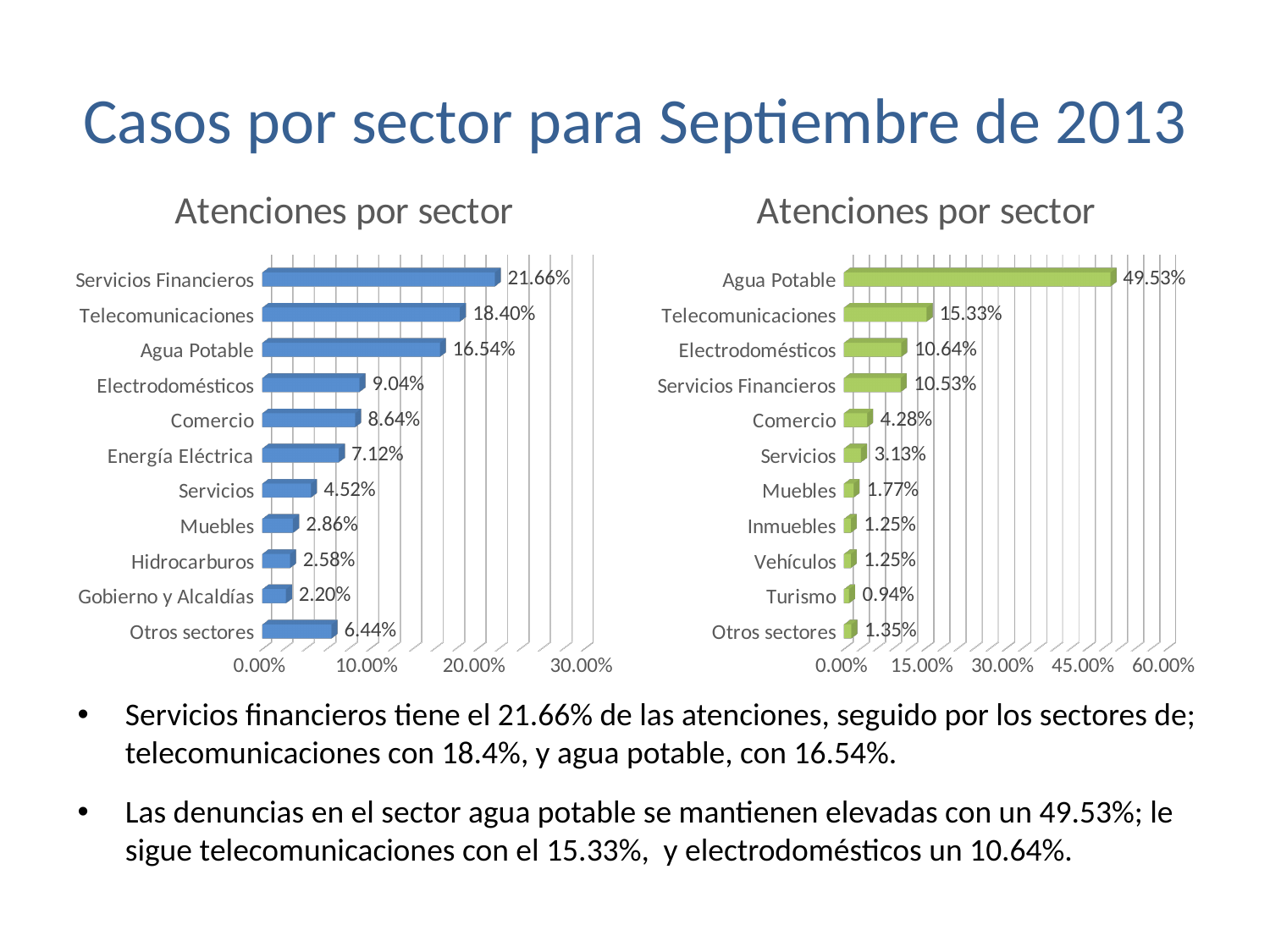
In the right chart, what is the value for Turismo? 0.94% How many sectors are shown in the right chart? 11 In the left chart, which is larger, Comercio or Servicios? Comercio What type of chart is the left chart? Bar chart In the right chart, what is the value for Agua Potable? 49.53% In the left chart, what is the difference between Servicios Financieros and Telecomunicaciones? 3.26% In the left chart, what is the value for Servicios Financieros? 21.66% In the left chart, what is the value for Energía Eléctrica? 7.12% In the right chart, which sector has the lowest value? Turismo In the right chart, what is the difference between Agua Potable and Telecomunicaciones? 34.20% What is the title of the right chart? Atenciones por sector In the left chart, which sector has the highest value? Servicios Financieros